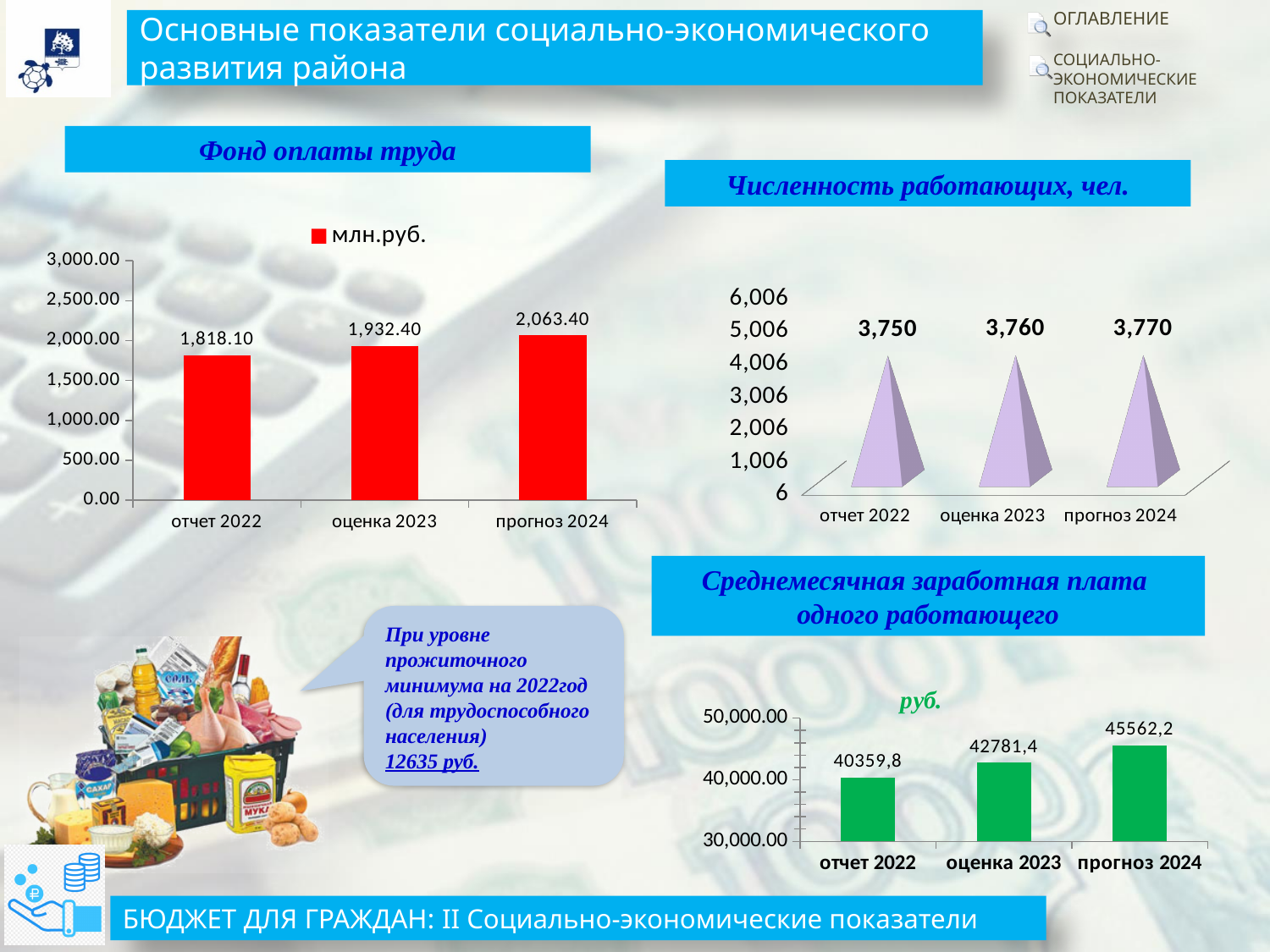
In the 'Фонд оплаты труда' chart, what is the value for прогноз 2024? 2,063.40 In the 'Численность работающих, чел.' chart, which category has the highest value? прогноз 2024 In the 'Численность работающих, чел.' chart, what is the value for оценка 2023? 3,760 In the 'Фонд оплаты труда' chart, what is the difference between прогноз 2024 and отчет 2022? 245.30 In the 'Фонд оплаты труда' chart, what kind of chart is shown? bar chart In the 'Среднемесячная заработная плата одного работающего' chart, do the values rise or fall from отчет 2022 to прогноз 2024? rise In the 'Фонд оплаты труда' chart, what series name does the legend show? млн.руб. In the 'Фонд оплаты труда' chart, what is the value for отчет 2022? 1,818.10 In the 'Среднемесячная заработная плата одного работающего' chart, what is the value for оценка 2023? 42781,4 In the 'Среднемесячная заработная плата одного работающего' chart, which category has the lowest value? отчет 2022 In the 'Численность работающих, чел.' chart, what is the difference between прогноз 2024 and отчет 2022? 20 In the 'Численность работающих, чел.' chart, how many categories are shown on the x axis? 3